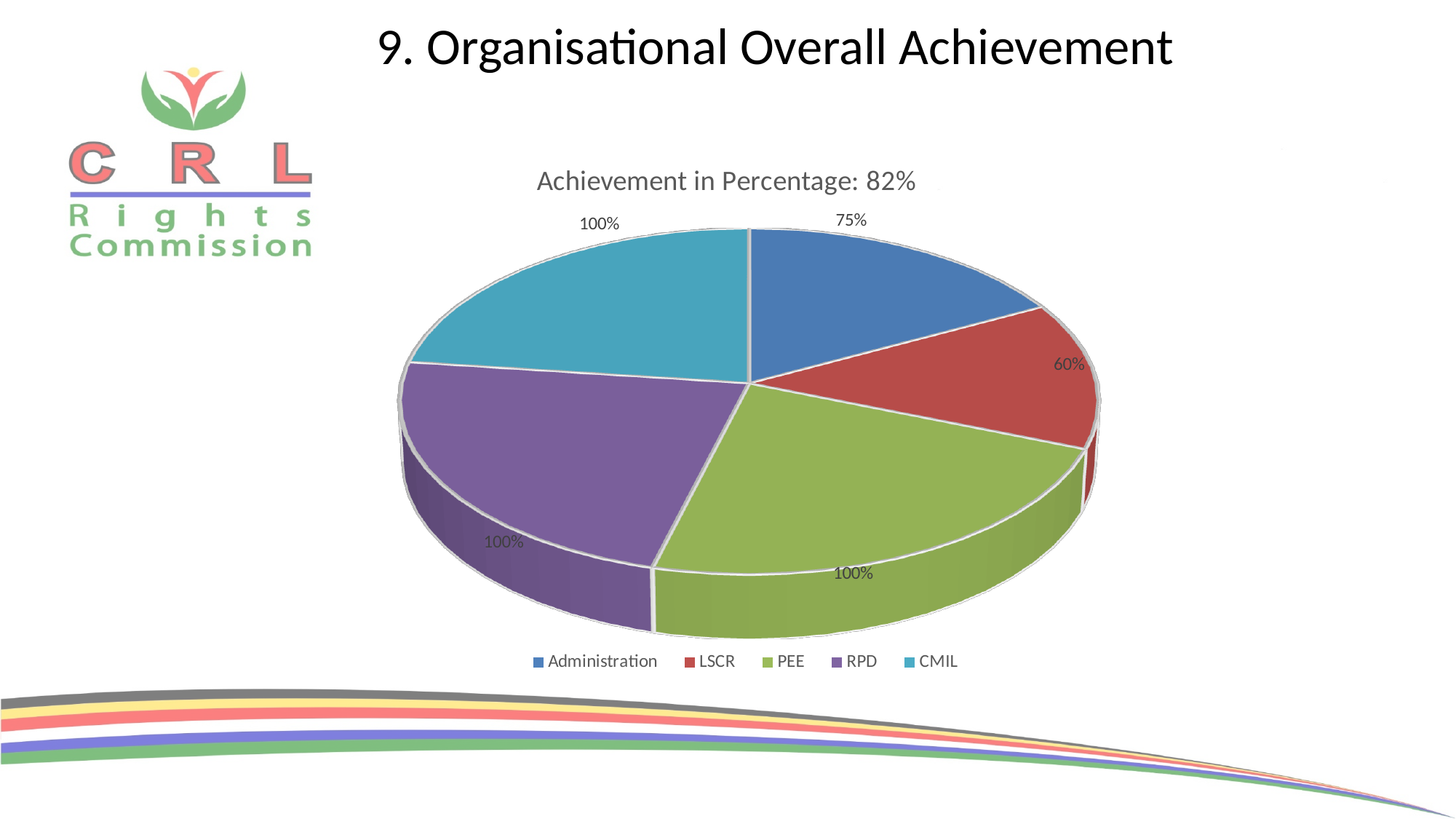
What is the value shown for LSCR in the pie chart? 60% How many categories are shown in the pie chart? 5 What is the value shown for Administration in the pie chart? 75% What is the difference between the value for RPD and the value for LSCR? 40% How many entries does the legend of the pie chart list? 5 What is the difference between the value for Administration and the value for LSCR? 15% What is the value shown for CMIL in the pie chart? 100% What kind of chart is shown on the slide? Pie chart What is the value shown for PEE in the pie chart? 100% Which is larger, the value for Administration or the value for LSCR? Administration What is the title of the chart on the slide? Achievement in Percentage: 82% Which category has the lowest value in the pie chart? LSCR